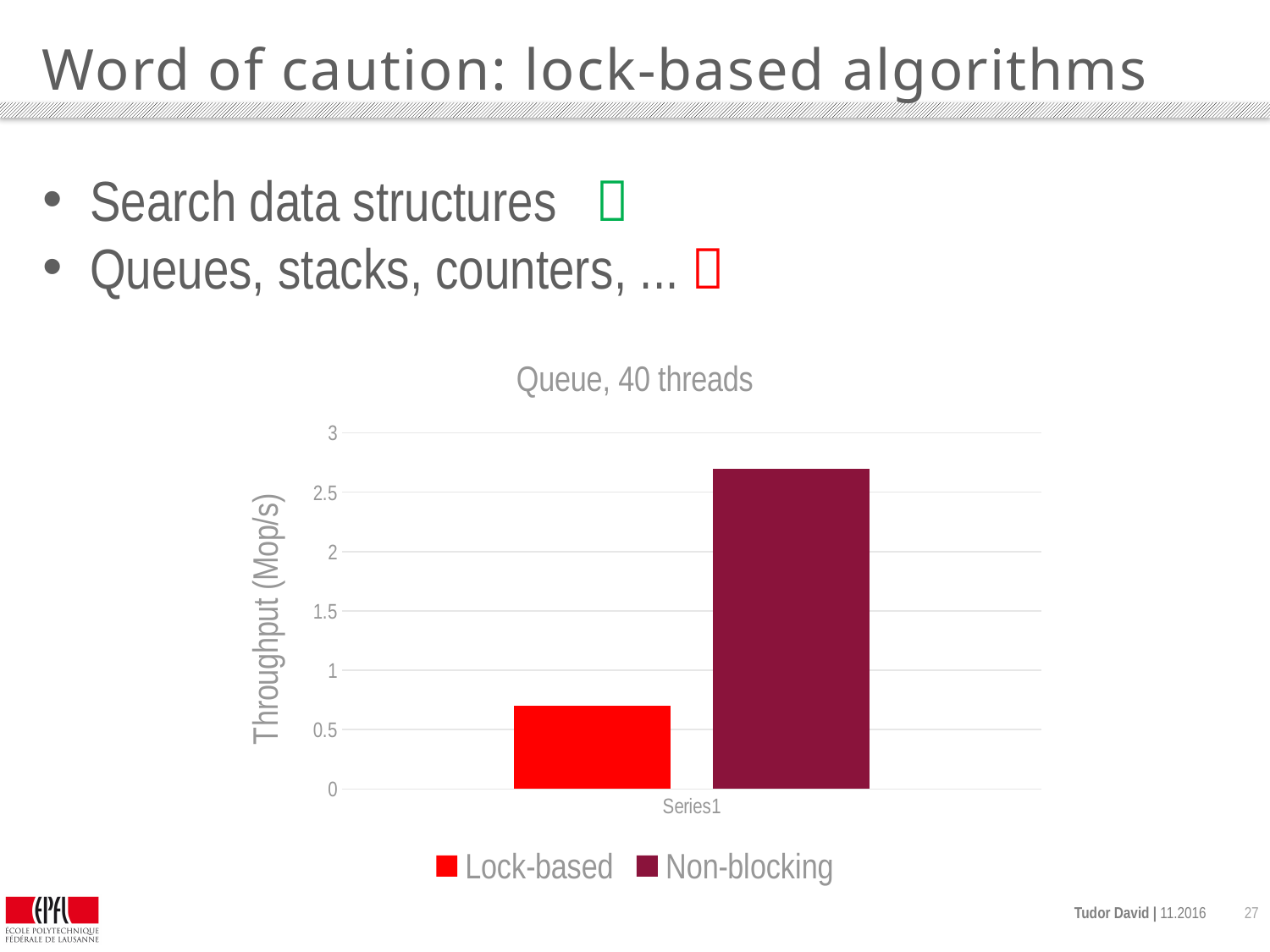
Is the throughput for Lock-based greater or less than 1 Mop/s? less Which series has the lowest throughput in the chart? Lock-based How many series does the chart legend list? 2 Which series has the highest throughput in the chart? Non-blocking What is the label of the y axis of the chart? Throughput (Mop/s) Is the throughput for Non-blocking greater or less than 3 Mop/s? less Is the throughput for Non-blocking greater or less than 2.5 Mop/s? greater What is the title of the chart? Queue, 40 threads How many categories are shown on the x axis of the chart? 1 Which series has the higher throughput, Lock-based or Non-blocking? Non-blocking What type of chart is shown on the slide? bar chart